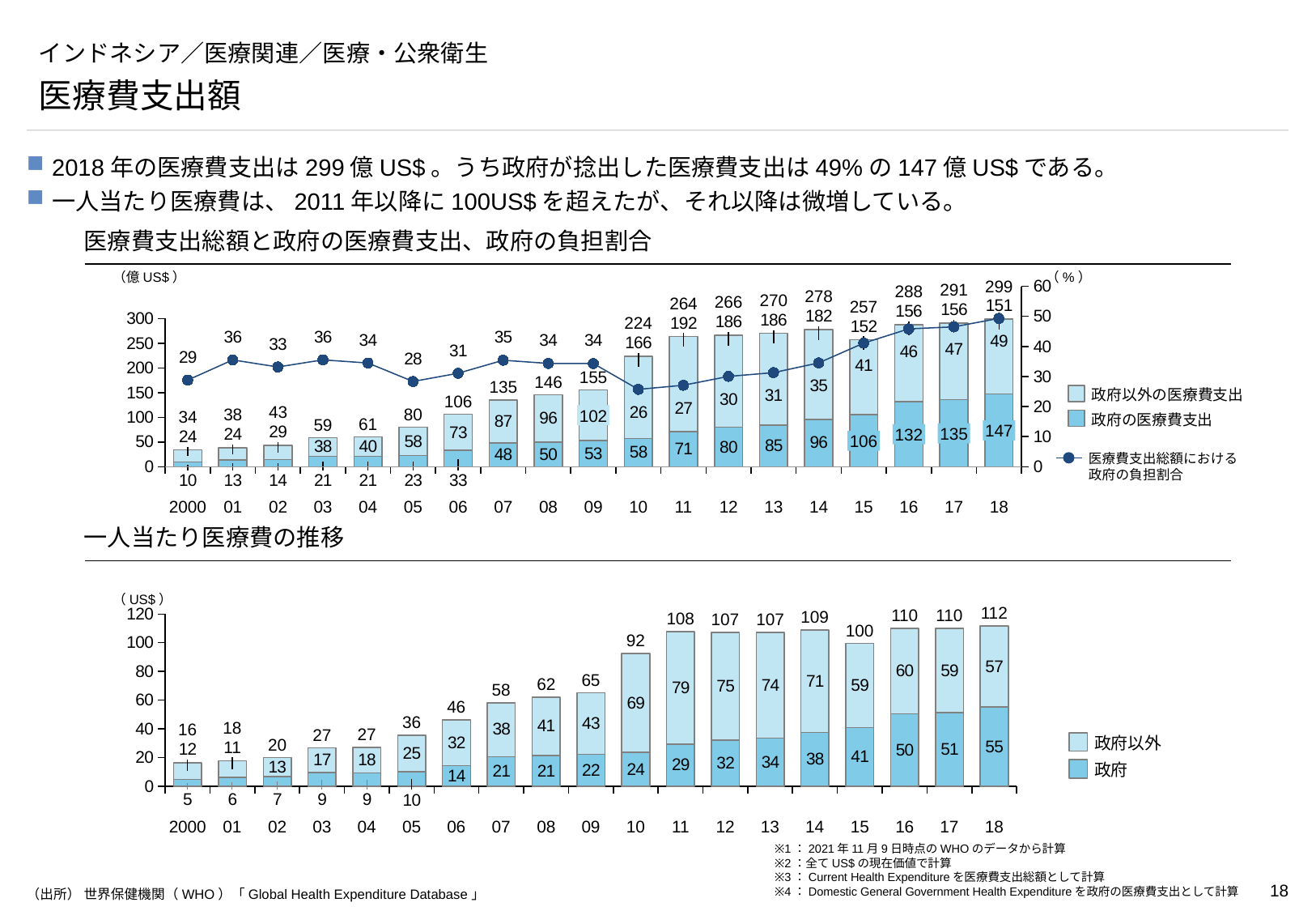
「一人当たり医療費の推移」のグラフには、いくつの年が示されていますか？ 19 「一人当たり医療費の推移」のグラフはどのような種類のグラフですか？ 積み上げ棒グラフ 「一人当たり医療費の推移」のグラフで、一人当たり医療費の合計が最も低い年はどれですか？ 2000 「医療費支出総額と政府の医療費支出、政府の負担割合」のグラフで、政府の負担割合が最も低い年はどれですか？ 2010 「医療費支出総額と政府の医療費支出、政府の負担割合」のグラフで、2018年の政府の医療費支出はいくらですか？ 147 「医療費支出総額と政府の医療費支出、政府の負担割合」のグラフで、2010年の医療費支出総額における政府の負担割合は何%ですか？ 26 「一人当たり医療費の推移」のグラフで、2015年の政府の一人当たり医療費はいくらですか？ 41 「医療費支出総額と政府の医療費支出、政府の負担割合」のグラフで、2018年の政府の医療費支出と2017年の政府の医療費支出の差はいくらですか？ 12 「一人当たり医療費の推移」のグラフで、2018年の一人当たり医療費の合計はいくらですか？ 112 「医療費支出総額と政府の医療費支出、政府の負担割合」のグラフの凡例には、いくつの系列が示されていますか？ 3 「医療費支出総額と政府の医療費支出、政府の負担割合」のグラフで、医療費支出総額が最も高い年はどれですか？ 2018 「医療費支出総額と政府の医療費支出、政府の負担割合」のグラフで、2011年の政府以外の医療費支出と2012年の政府以外の医療費支出ではどちらが大きいですか？ 2011